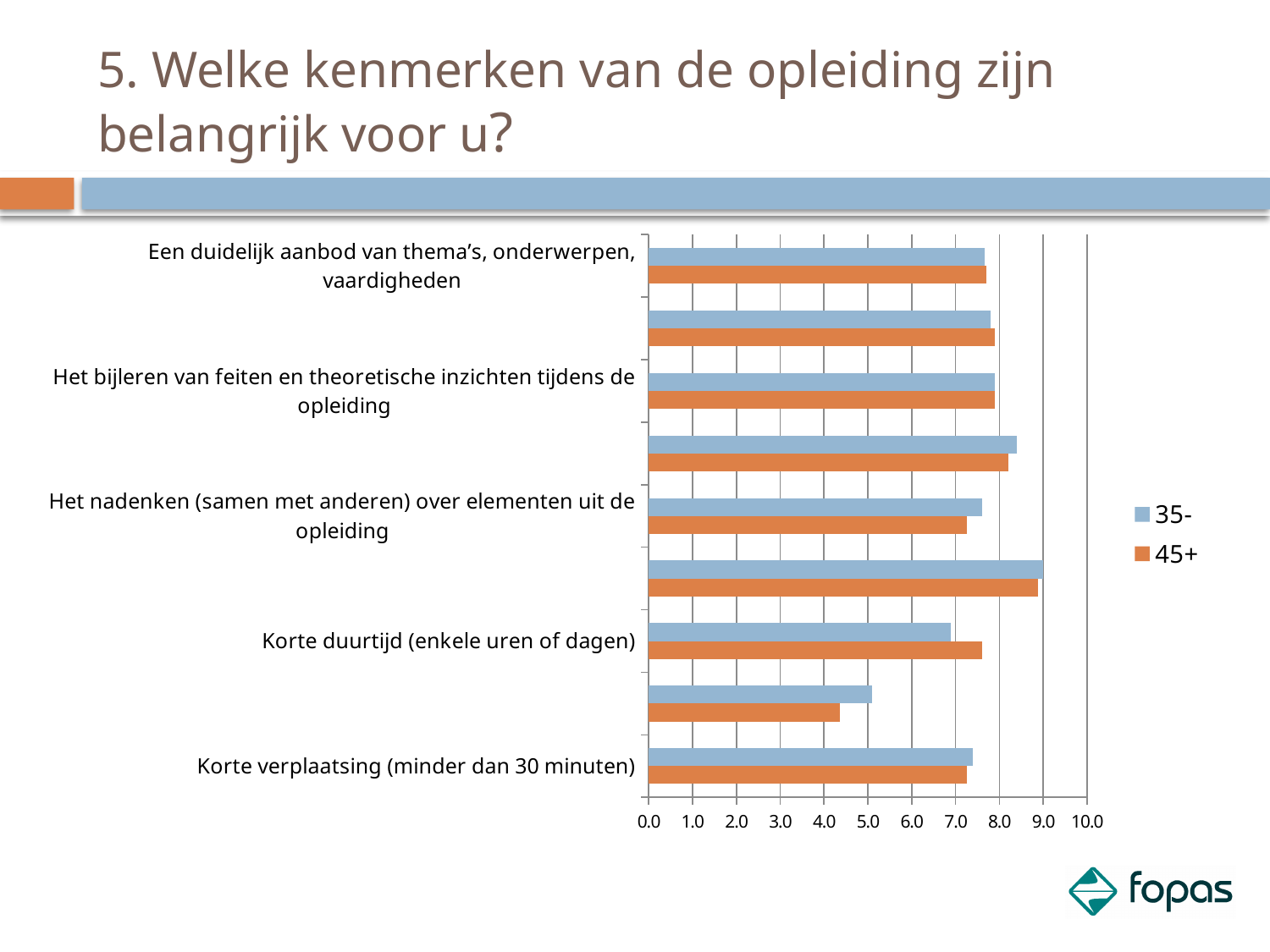
What is the title of the slide containing the chart? 5. Welke kenmerken van de opleiding zijn belangrijk voor u? Is the 45+ value for 'Korte duurtijd (enkele uren of dagen)' greater or less than 7.0? greater What are the two series named in the legend? 35- and 45+ Is the 35- value for 'Korte duurtijd (enkele uren of dagen)' greater or less than 8.0? less For 'Korte duurtijd (enkele uren of dagen)', which series has the larger value, 35- or 45+? 45+ Is the 35- value for 'Het bijleren van feiten en theoretische inzichten tijdens de opleiding' greater or less than 7.0? greater For 'Het nadenken (samen met anderen) over elementen uit de opleiding', which series has the larger value, 35- or 45+? 35- How many series does the legend list? 2 What kind of chart is shown on the slide? bar chart